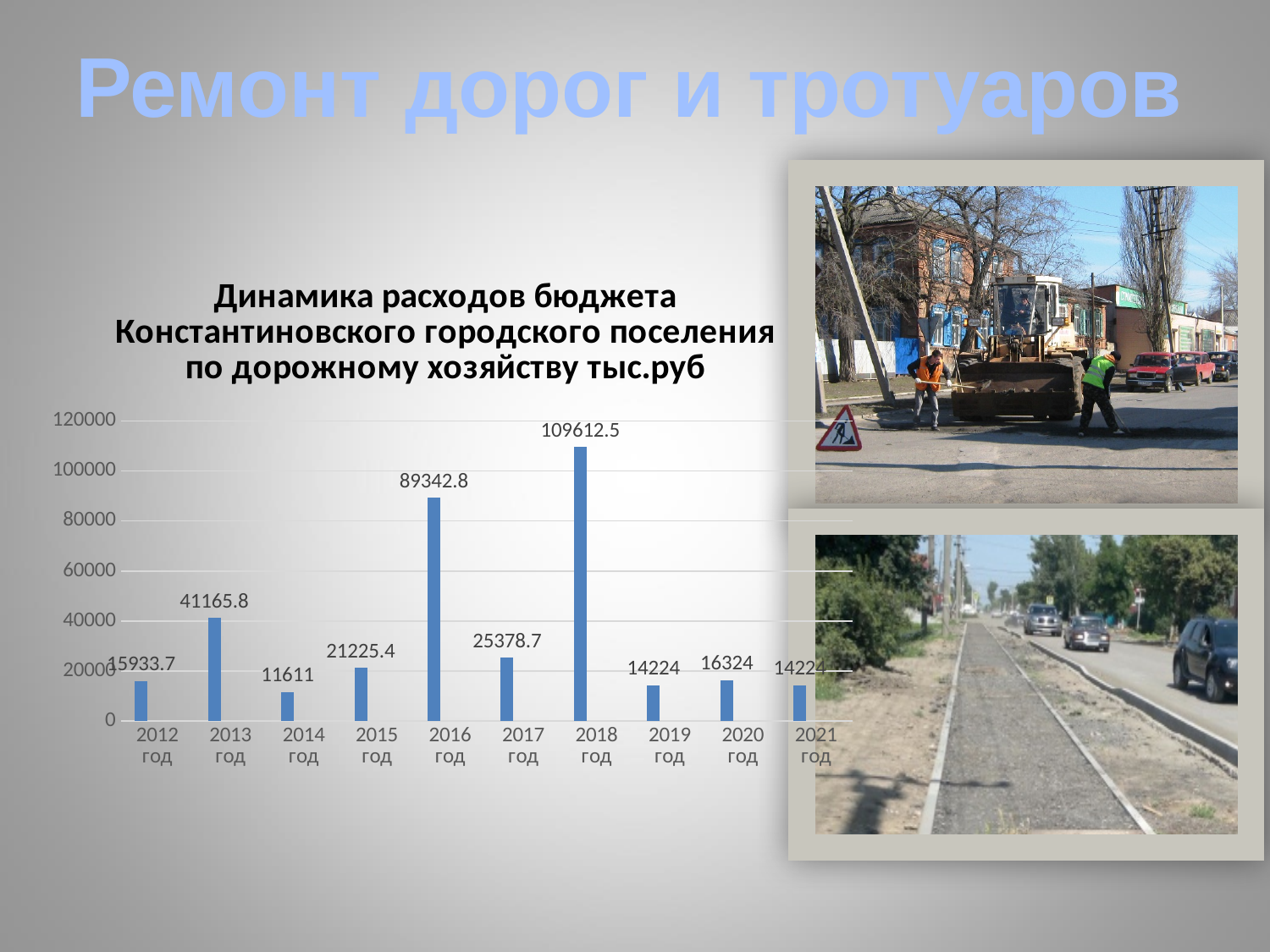
Which year has the lowest value? 2014 год What kind of chart is shown on the slide? bar chart What is the value for 2016 год? 89342.8 What is the value for 2020 год? 16324 What is the value for 2018 год? 109612.5 What is the value for 2014 год? 11611 How many years are shown on the x axis? 10 What is the title of the chart? Динамика расходов бюджета Константиновского городского поселения по дорожному хозяйству тыс.руб Is the value for 2016 год greater or less than 80000? greater Which year has the highest value? 2018 год What is the difference between the values for 2018 год and 2016 год? 20269.7 Which is larger, the value for 2013 год or the value for 2017 год? 2013 год